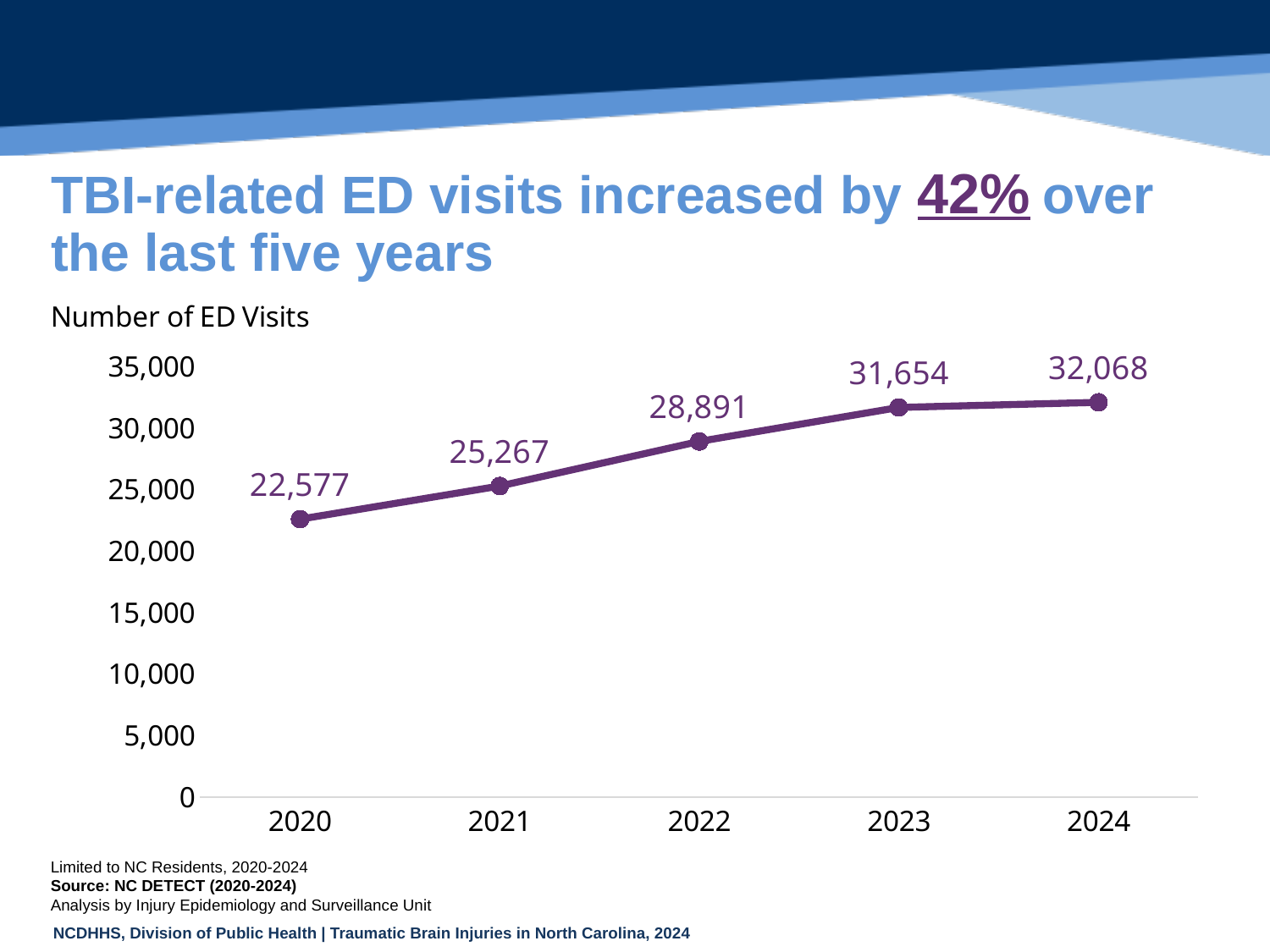
Which year had more ED visits, 2021 or 2023? 2023 Which year had the lowest number of ED visits? 2020 How many years are plotted on the chart? 5 What is the difference in ED visits between 2024 and 2020? 9,491 What kind of chart is shown on the slide? line chart What was the number of ED visits in 2024? 32,068 What is the difference in ED visits between 2022 and 2021? 3,624 Do the number of ED visits rise or fall from 2020 to 2024? rise What was the number of ED visits in 2020? 22,577 Which year had the highest number of ED visits? 2024 Is the value for 2022 greater or less than 30,000? less What was the number of ED visits in 2022? 28,891